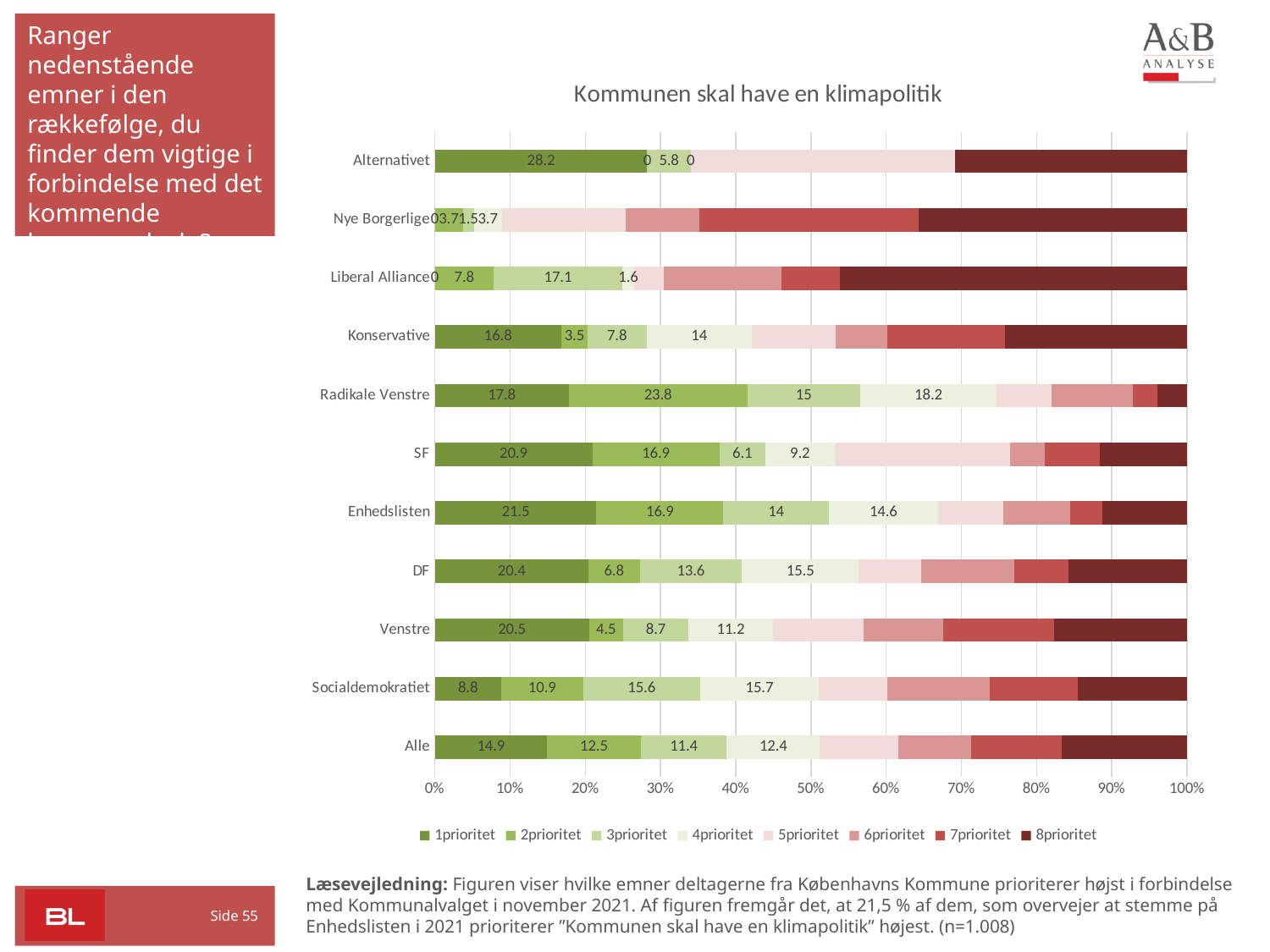
How many categories (parties including Alle) are shown on the y axis? 11 What is the 1prioritet value for Alle? 14.9 How many series does the legend list? 8 What is the 1prioritet value for Enhedslisten? 21.5 Which party has the highest 1prioritet value? Alternativet Which is larger, the 2prioritet value for Radikale Venstre or for SF? Radikale Venstre Is the 8prioritet share for Liberal Alliance greater or less than 40%? greater Which party has the lowest 1prioritet value among Socialdemokratiet, Venstre, DF and SF? Socialdemokratiet What is the 2prioritet value for Radikale Venstre? 23.8 What is the 4prioritet value for Socialdemokratiet? 15.7 What is the difference between the 1prioritet values for Enhedslisten and Socialdemokratiet? 12.7 What kind of chart is shown on the slide? Stacked bar chart